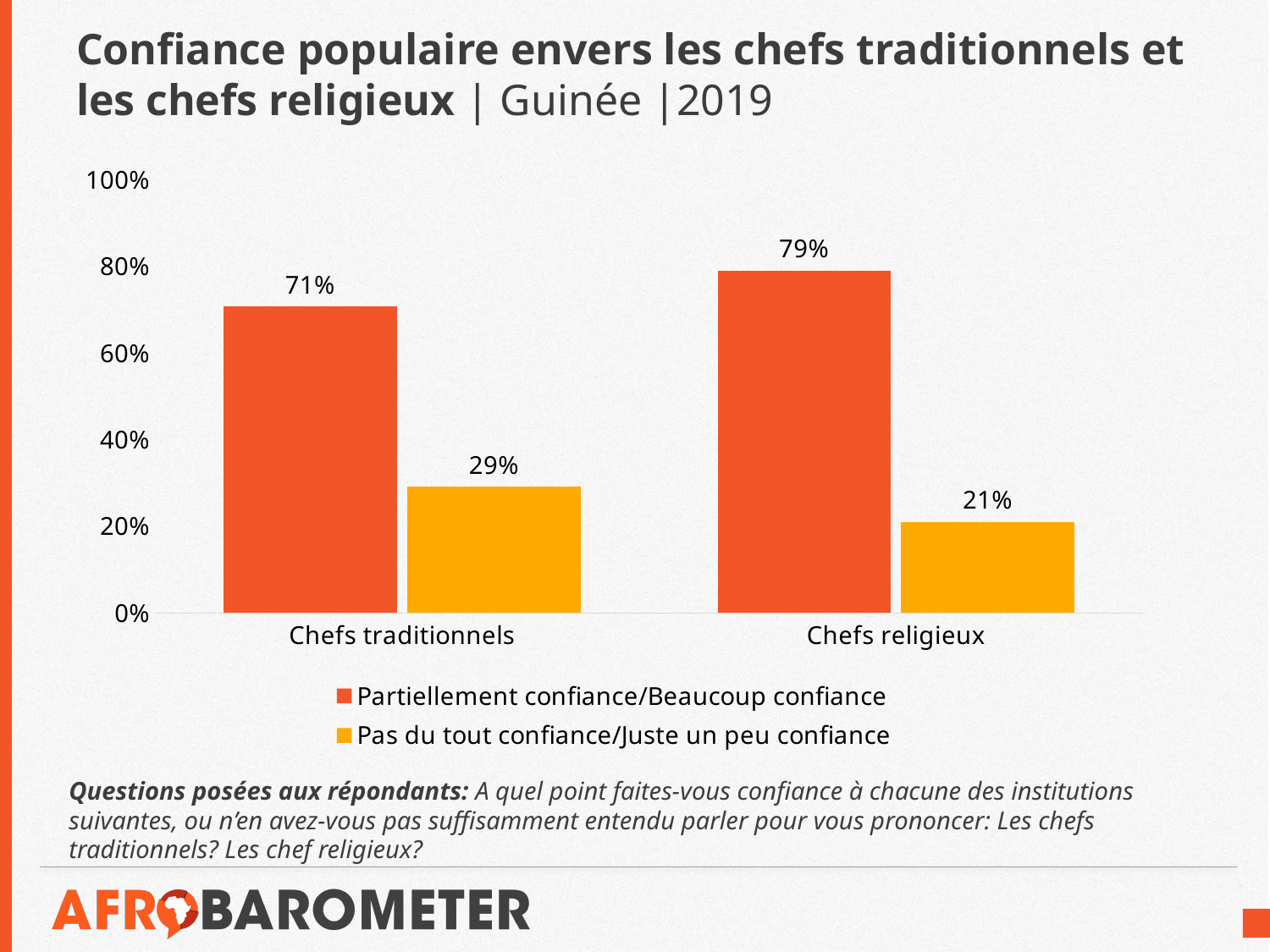
How many categories are shown on the x axis? 2 Which category has the lowest value for 'Pas du tout confiance/Juste un peu confiance'? Chefs religieux Is the 'Pas du tout confiance/Juste un peu confiance' value for Chefs traditionnels larger or smaller than that for Chefs religieux? larger What is the difference between the 'Partiellement confiance/Beaucoup confiance' values for Chefs religieux and Chefs traditionnels? 8 percentage points What kind of chart is shown on the slide? bar chart What is the value for 'Pas du tout confiance/Juste un peu confiance' for Chefs traditionnels? 29% What is the value for 'Partiellement confiance/Beaucoup confiance' for Chefs religieux? 79% Is the 'Partiellement confiance/Beaucoup confiance' value for Chefs traditionnels greater or less than 60%? greater How many series does the legend list? 2 What percentage of respondents have partial or a lot of confidence in traditional chiefs (Chefs traditionnels)? 71% Which category has the higher value for 'Partiellement confiance/Beaucoup confiance'? Chefs religieux What is the value for 'Pas du tout confiance/Juste un peu confiance' for Chefs religieux? 21%